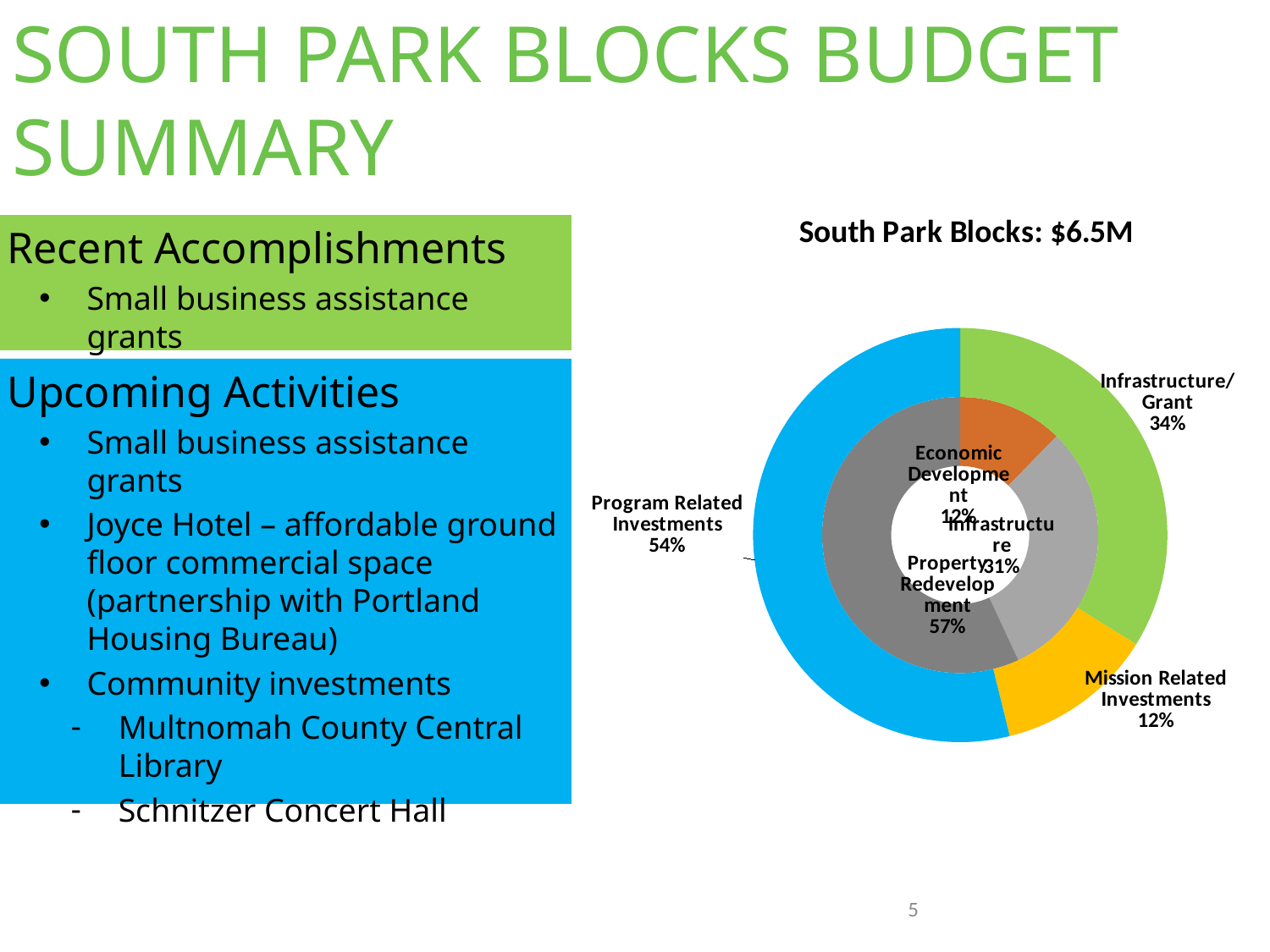
Which category in the outer ring has the smallest share? Mission Related Investments What is the title of the chart? South Park Blocks: $6.5M What percentage is shown for Property Redevelopment in the inner ring? 57% How many percentage points larger is Program Related Investments than Infrastructure/Grant? 20 percentage points Which category in the inner ring has the largest share? Property Redevelopment What share of the South Park Blocks budget goes to Program Related Investments in the outer ring? 54% What percentage is shown for Mission Related Investments? 12% What percentage is shown for Infrastructure/Grant in the outer ring of the chart? 34% Which category in the outer ring has the largest share? Program Related Investments Which is larger, Infrastructure/Grant or Mission Related Investments? Infrastructure/Grant What percentage is shown for Infrastructure in the inner ring? 31% What kind of chart is shown on the slide? Doughnut chart